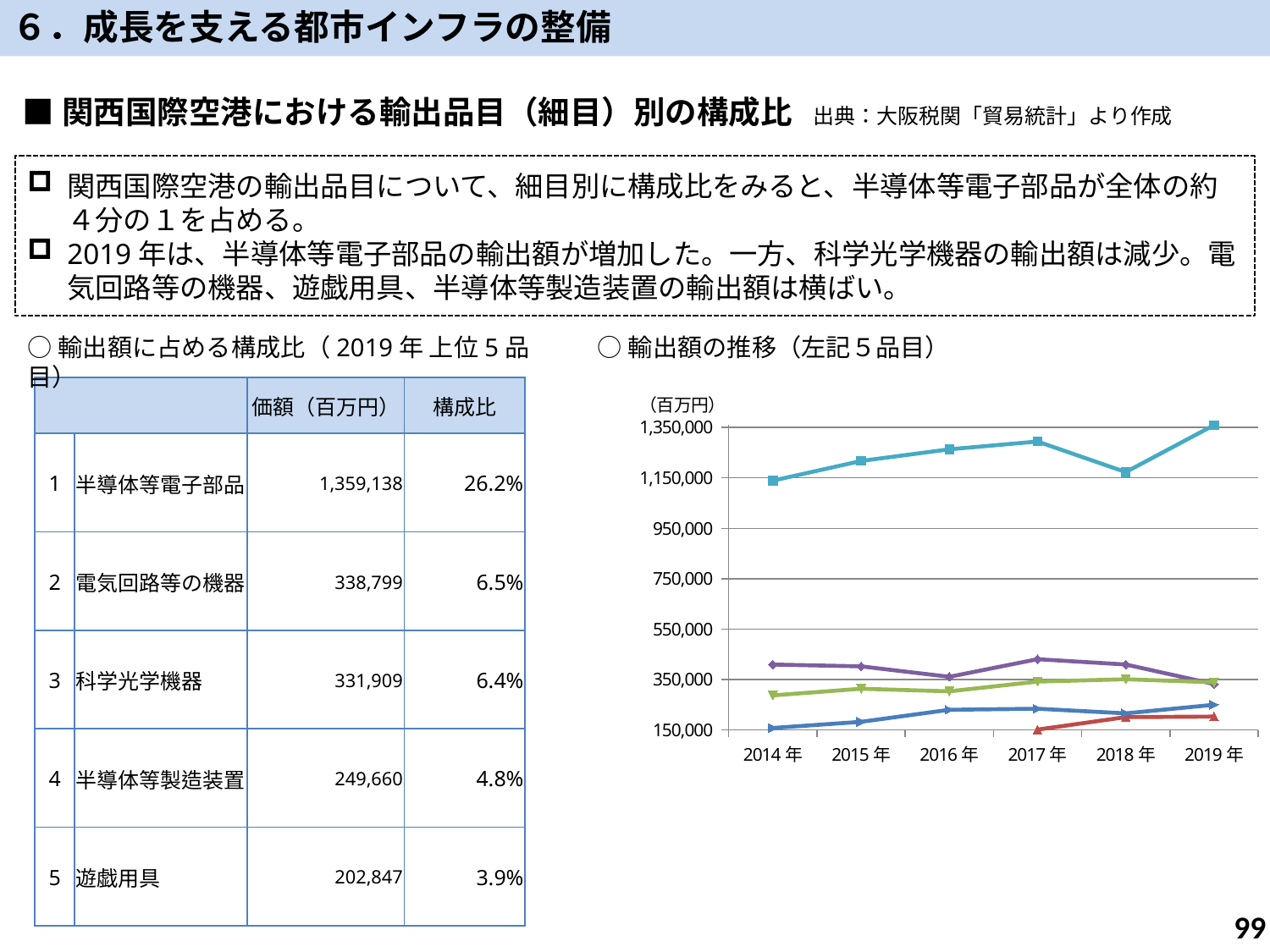
In the 輸出額の推移 chart, is the value of the topmost line in 2018年 greater or less than 1,350,000? less What is the last year shown on the x axis of the 輸出額の推移 chart? 2019年 In the 輸出額の推移 chart, in which year is the topmost line at its highest? 2019年 In the 輸出額の推移 chart, is the value of the topmost line in 2014年 greater or less than 950,000? greater In the 輸出額の推移 chart, does the topmost line rise or fall from 2017年 to 2018年? fall How many years are shown on the x axis of the 輸出額の推移 chart? 6 What is the first year shown on the x axis of the 輸出額の推移 chart? 2014年 In the 輸出額の推移 chart, does the topmost line rise or fall from 2018年 to 2019年? rise How many lines are plotted in the 輸出額の推移 chart? 5 In the 輸出額の推移 chart, in which year is the topmost line at its lowest? 2014年 What kind of chart is shown under the heading 輸出額の推移（左記５品目）? line chart In the 輸出額の推移 chart, is the value of the topmost line in 2019年 greater or less than 1,150,000? greater